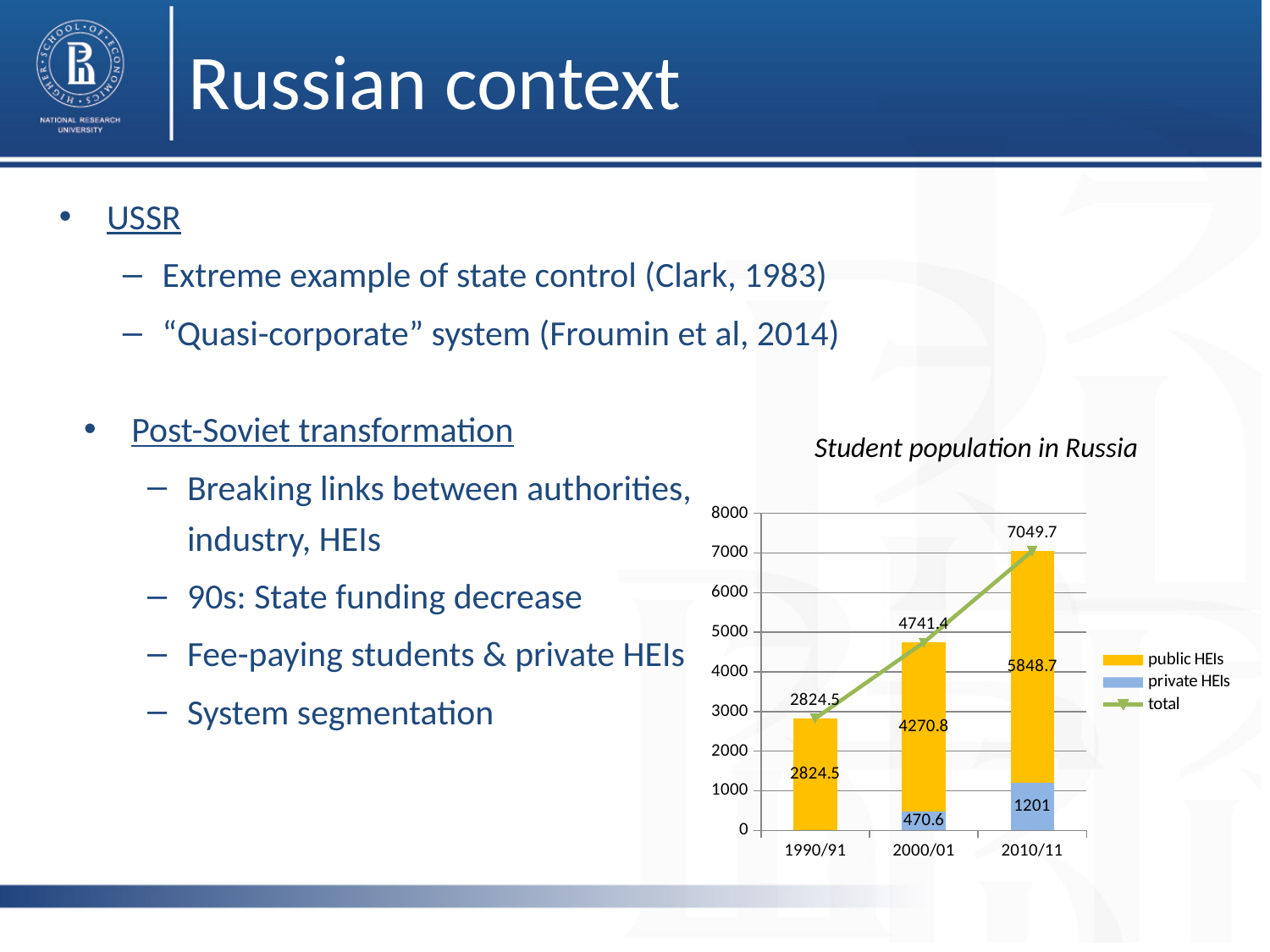
What is the total student population shown for 2000/01? 4741.4 Which is larger: private HEIs in 2010/11 or private HEIs in 2000/01? private HEIs in 2010/11 Which year has the highest total student population? 2010/11 What is the value for public HEIs in 2010/11? 5848.7 Which year has the lowest value for public HEIs? 1990/91 Does the total student population rise or fall from 1990/91 to 2010/11? rise What is the value for private HEIs in 2000/01? 470.6 How many year categories are shown on the x axis? 3 What kind of chart is this? stacked bar chart with a line How many series does the legend list? 3 What is the title of the chart? Student population in Russia What is the difference between the total for 2010/11 and the total for 1990/91? 4225.2